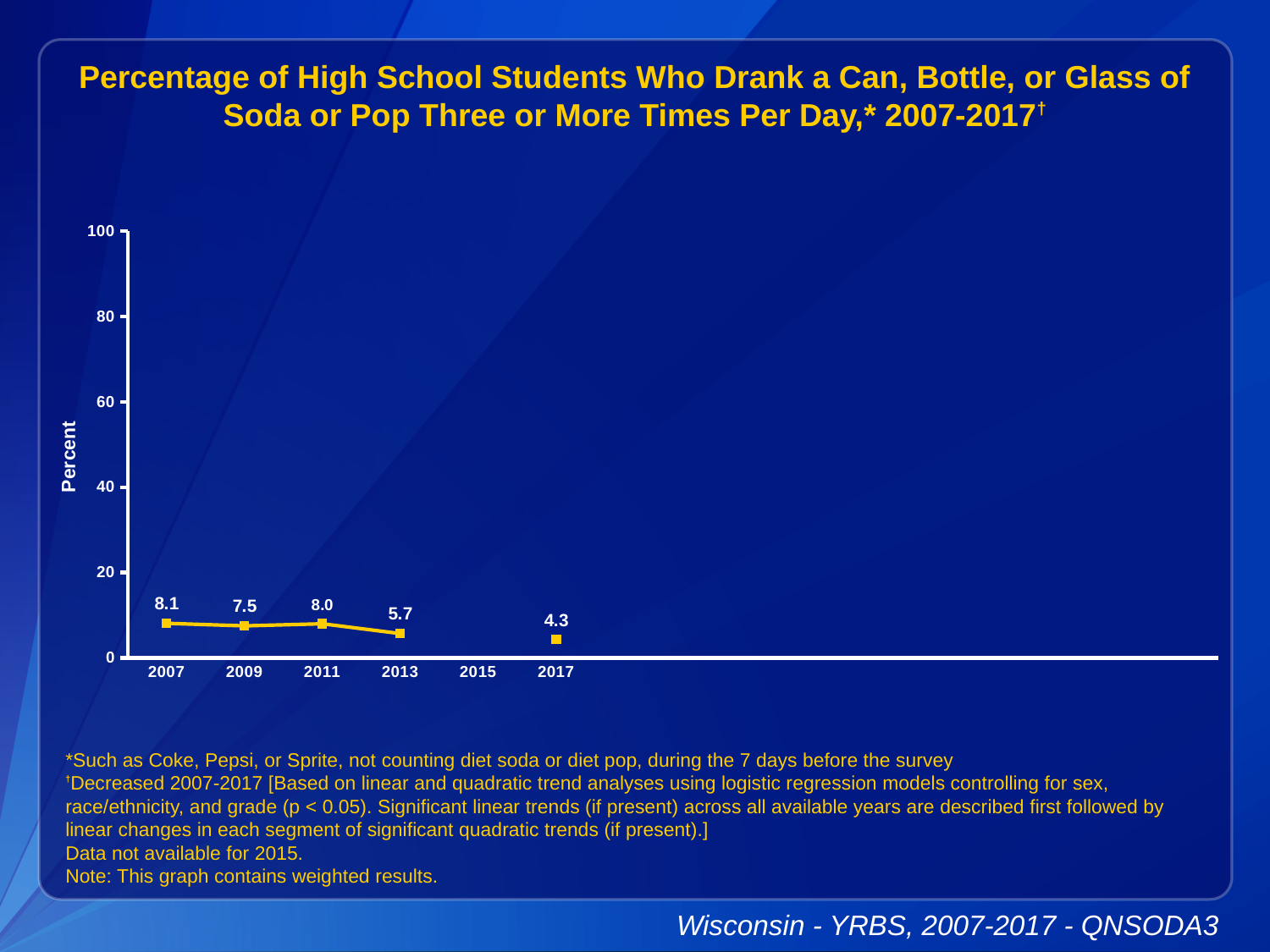
Do the values generally rise or fall from 2007 to 2017? fall What is the value plotted for 2013? 5.7 How many years have data points plotted on the chart? 5 What percentage of high school students drank soda or pop three or more times per day in 2007? 8.1 What is the value plotted for 2017? 4.3 Which year has the highest value on the chart? 2007 Which year on the x axis has no data plotted? 2015 Which is larger, the value for 2009 or the value for 2011? 2011 Which year has the lowest value on the chart? 2017 What is the difference between the 2007 value and the 2017 value? 3.8 What kind of chart is shown on the slide? line chart Is the value for 2007 greater or less than 20? less